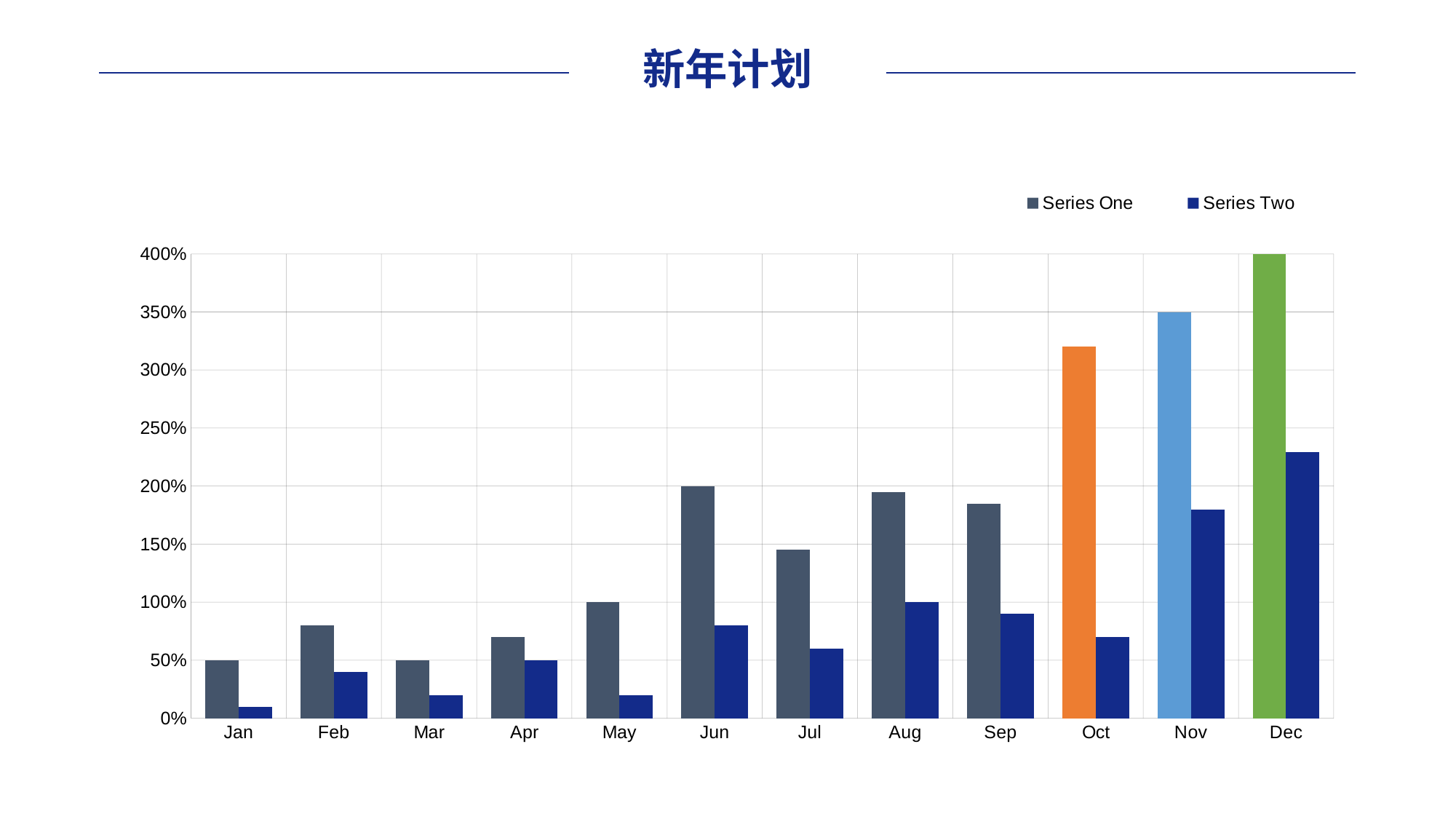
Is the Series One value for Oct greater or less than 300%? greater Which month has the lowest Series Two value? Jan What is the Series One value for Jun? 200% How many months are shown on the x axis? 12 What kind of chart is shown on the slide? bar chart What is the Series One value for Nov? 350% Which month has the highest Series One value? Dec What is the Series One value for Dec? 400% How many series does the legend list? 2 What is the Series Two value for Aug? 100% What is the difference between the Series One values for Dec and Nov? 50% Which is larger, the Series One value for Jun or for Jul? Jun